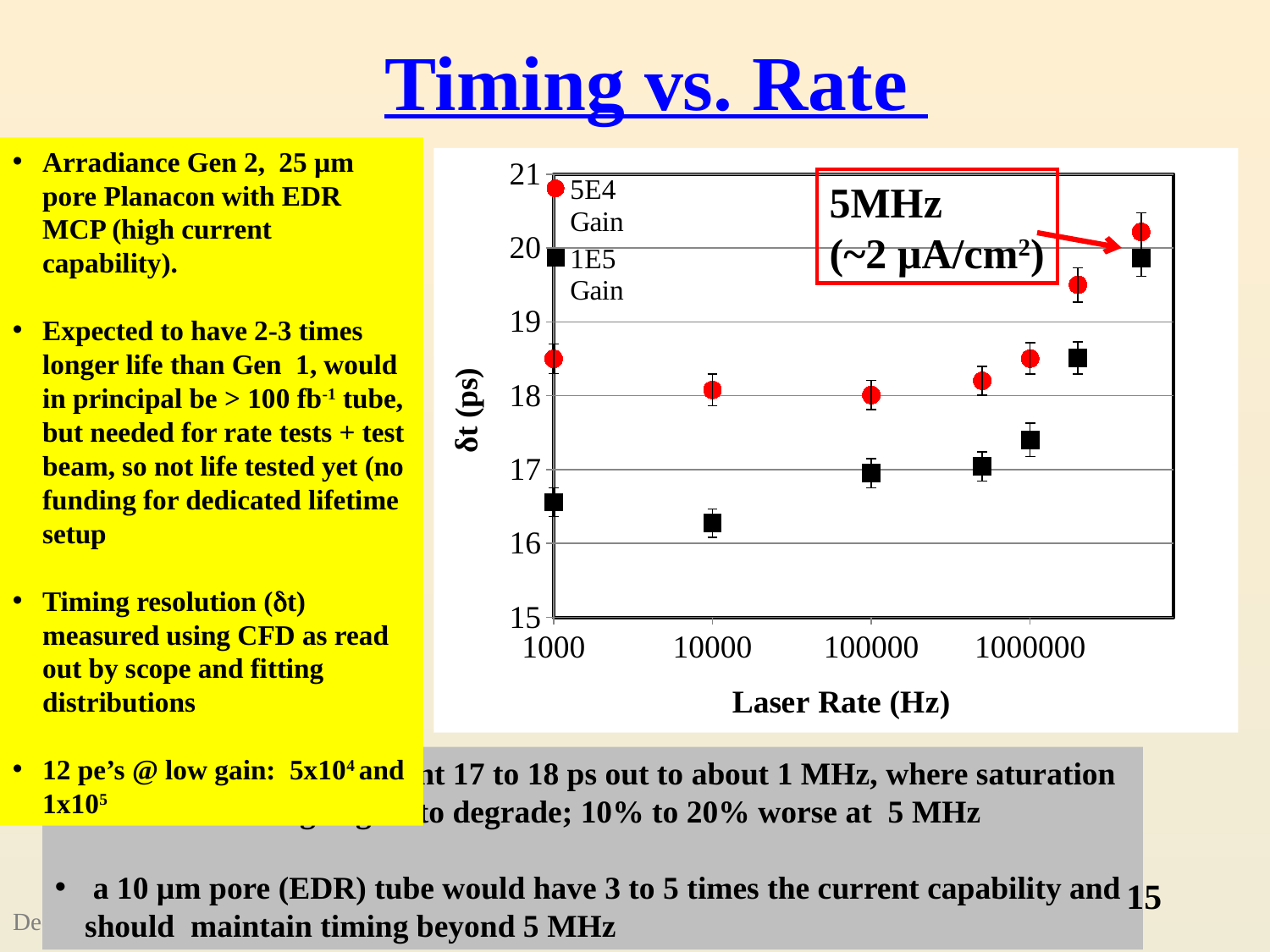
At which laser rate does the 5E4 Gain series reach its highest δt? 5 MHz What are the two series named in the chart's legend? 5E4 Gain and 1E5 Gain How many series does the chart's legend list? 2 What kind of chart is shown on the slide? scatter plot At a laser rate of 100000 Hz, which series has the higher δt, 5E4 Gain or 1E5 Gain? 5E4 Gain Is the δt value for the 5E4 Gain series at a laser rate of 10000 Hz greater or less than 19 ps? less Is the δt value for the 1E5 Gain series at a laser rate of 10000 Hz greater or less than 17 ps? less How many data points are plotted for the 5E4 Gain series? 7 What is the title of the x axis of the chart? Laser Rate (Hz) Does the δt for the 1E5 Gain series rise or fall as the laser rate increases from 100000 Hz to the highest rate plotted? rise Is the δt value for the 5E4 Gain series at a laser rate of 1000 Hz greater or less than 18 ps? greater